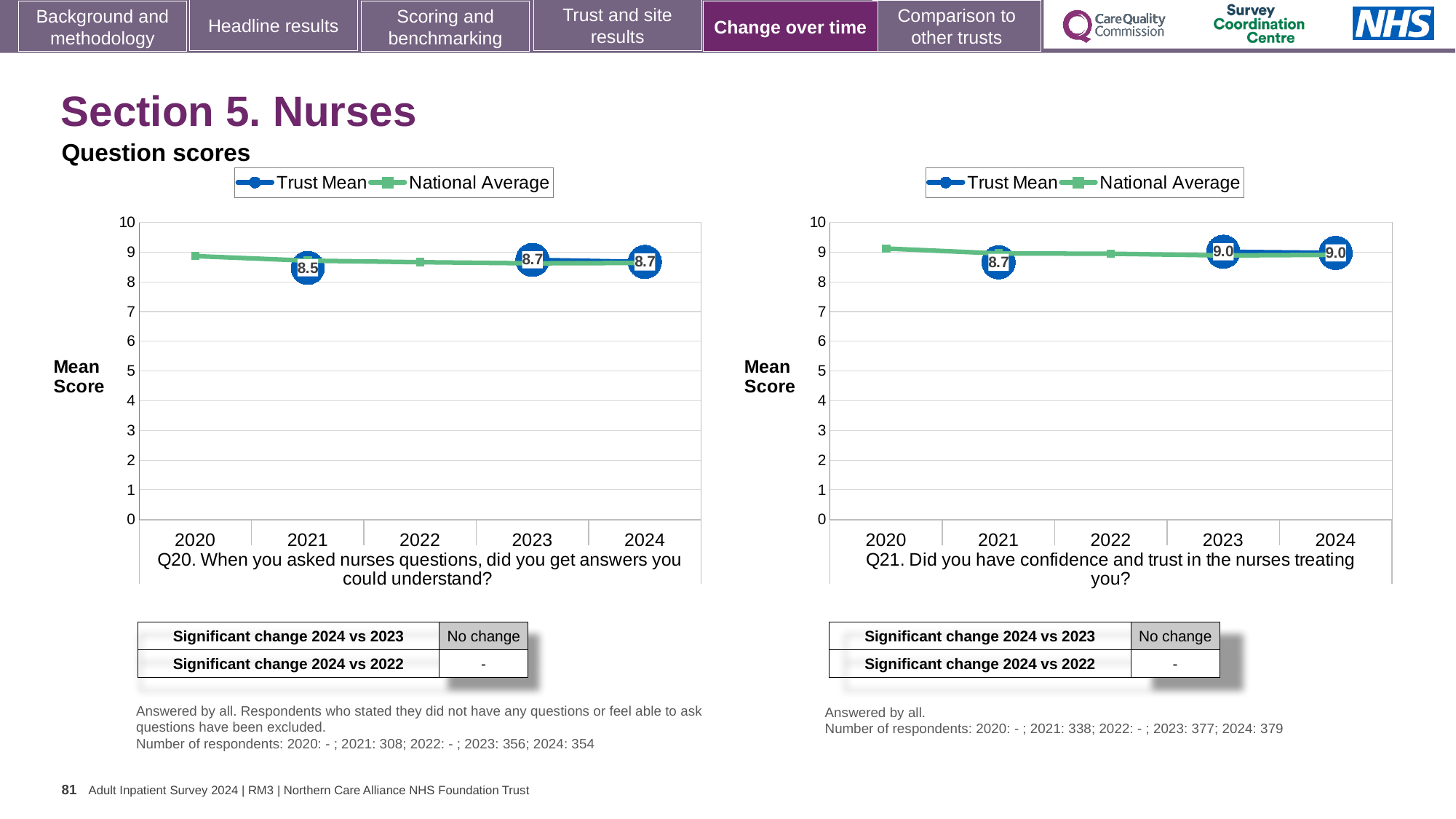
In the Q20 chart, is the National Average value for 2020 greater or less than 8? greater In the Q20 chart, what is the difference between the Trust Mean scores for 2023 and 2021? 0.2 In the Q21 chart, what is the difference between the Trust Mean scores for 2024 and 2021? 0.3 In the Q20 chart, what is the Trust Mean score for 2021? 8.5 In the Q21 chart, what is the Trust Mean score for 2021? 8.7 In the Q21 chart, what is the Trust Mean score for 2023? 9.0 In the Q20 chart, is the Trust Mean score for 2023 larger or smaller than for 2021? larger How many years are shown on the x axis of the Q21 chart? 5 What kind of chart is the Q20 chart? line chart In the Q21 chart, which year has the lowest Trust Mean score? 2021 How many series does the legend of the Q21 chart list? 2 In the Q20 chart, what is the Trust Mean score for 2024? 8.7